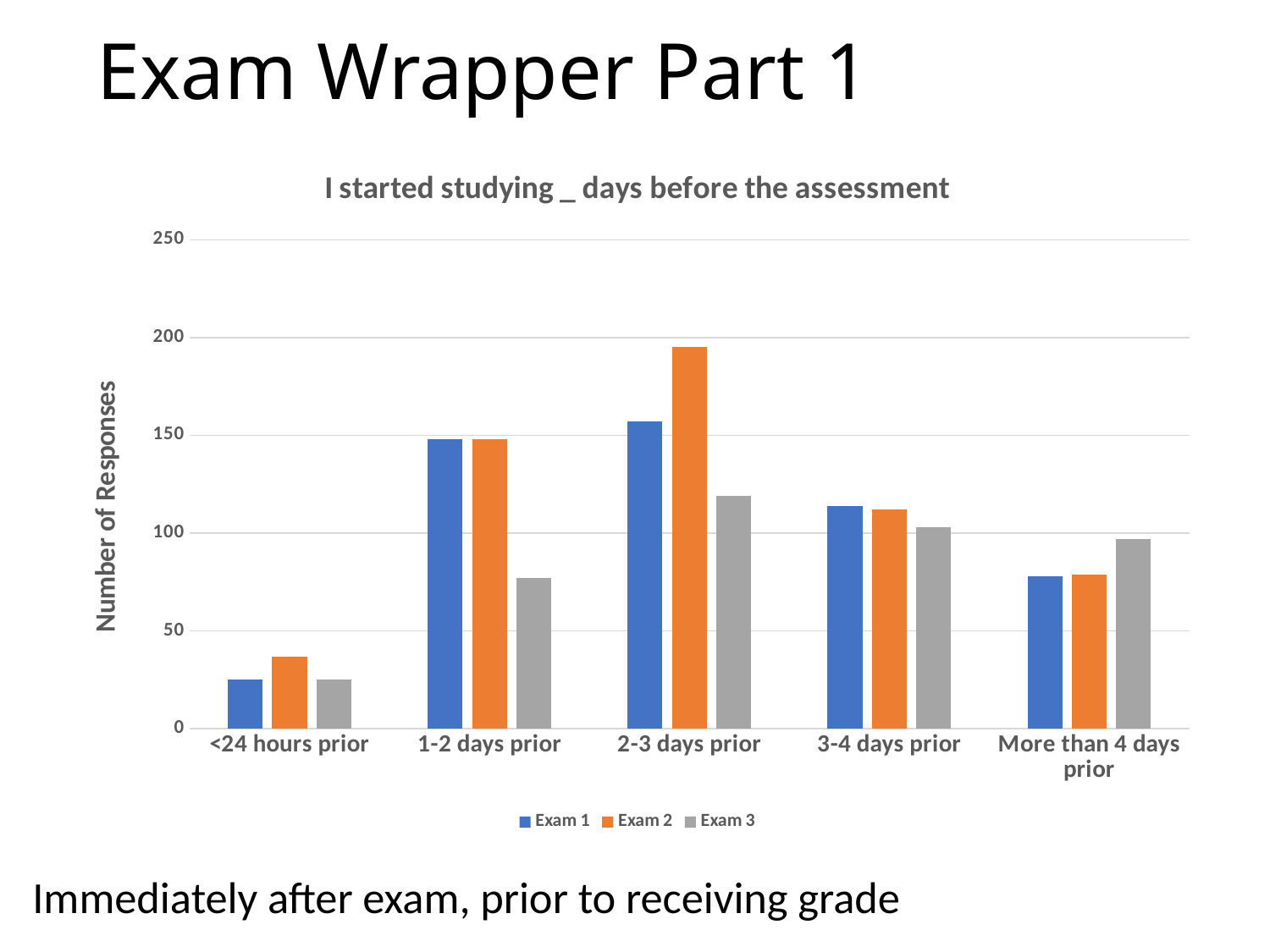
What is the label of the vertical axis? Number of Responses Is the value for Exam 3 at 1-2 days prior greater or less than 100? less For Exam 2, which category has the highest number of responses? 2-3 days prior At 2-3 days prior, which is larger: Exam 2 or Exam 3? Exam 2 How many categories are shown on the x axis? 5 How many series does the legend list? 3 For Exam 3, which category has the lowest number of responses? <24 hours prior At More than 4 days prior, which is larger: Exam 1 or Exam 3? Exam 3 What type of chart is shown on the slide? bar chart Is the value for Exam 1 at <24 hours prior greater or less than 50? less What is the title of the chart? I started studying _ days before the assessment Is the value for Exam 2 at 2-3 days prior greater or less than 150? greater